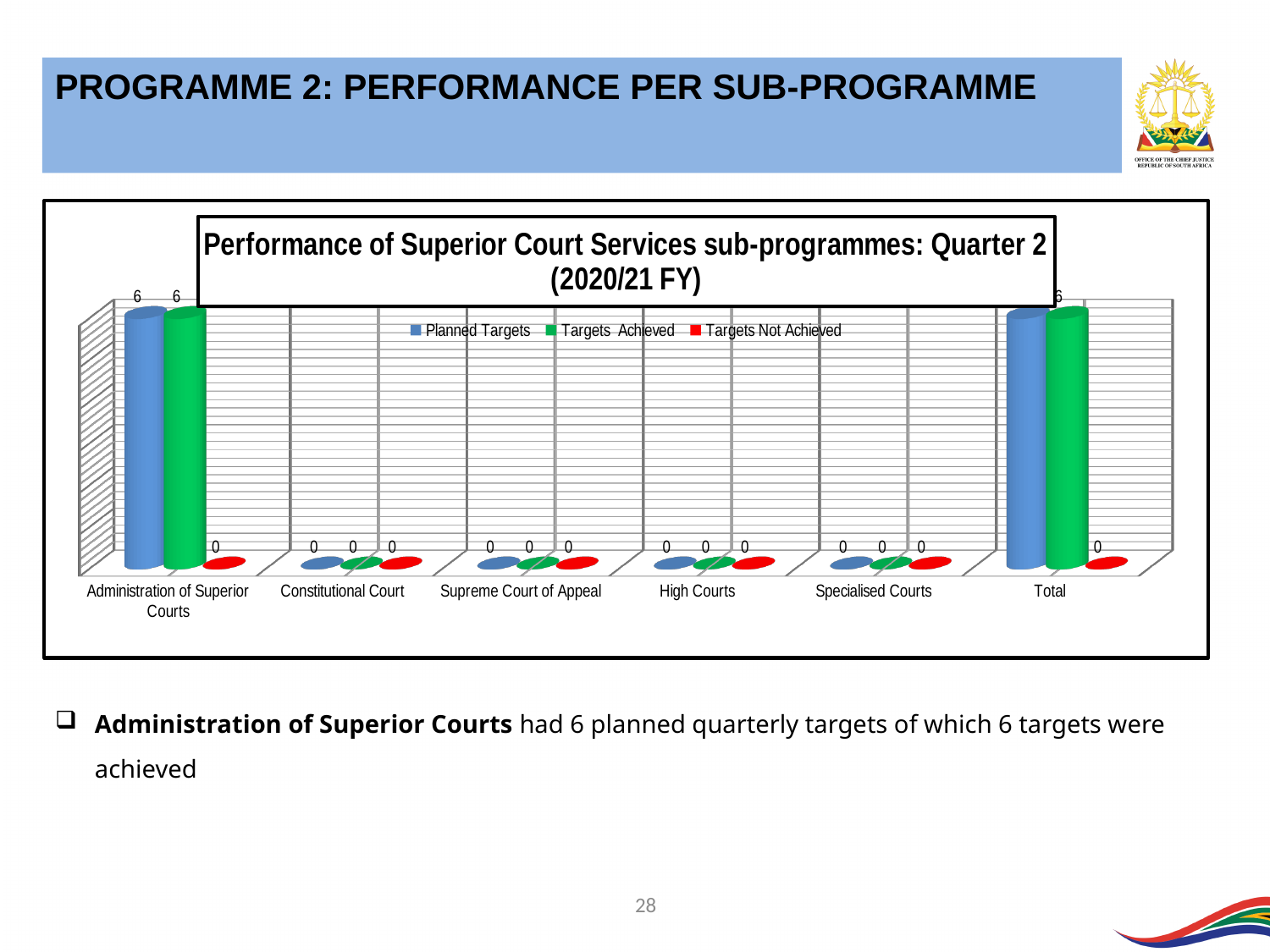
How many series does the legend list? 3 Which has the larger Planned Targets value, Administration of Superior Courts or Specialised Courts? Administration of Superior Courts What kind of chart is shown on the slide? Bar chart What is the title of the chart? Performance of Superior Court Services sub-programmes: Quarter 2 (2020/21 FY) What is the value of Targets Not Achieved for Administration of Superior Courts? 0 What is the value of Targets Achieved for Administration of Superior Courts? 6 What is the value of Targets Not Achieved for Total? 0 What is the value of Planned Targets for Constitutional Court? 0 How many categories are shown along the x axis? 6 What is the value of Planned Targets for Administration of Superior Courts? 6 What is the value of Targets Achieved for High Courts? 0 What is the difference between Planned Targets and Targets Achieved for Administration of Superior Courts? 0